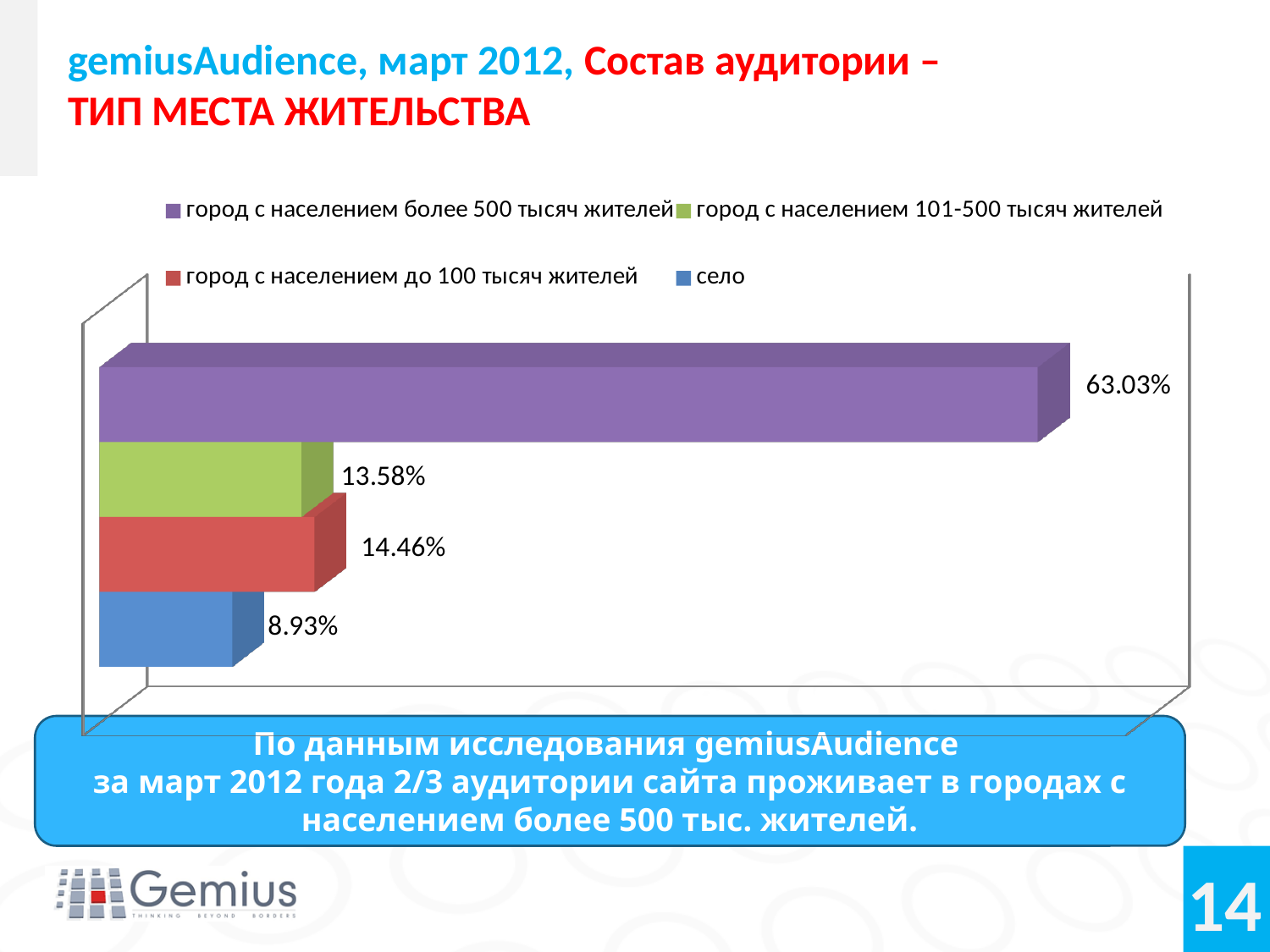
Which category has the highest value? город с населением более 500 тысяч жителей How many series does the legend list? 4 Which is larger: the value for город с населением до 100 тысяч жителей or for город с населением 101-500 тысяч жителей? город с населением до 100 тысяч жителей What is the value for город с населением 101-500 тысяч жителей? 13.58% What kind of chart is shown on the slide? bar chart What is the value for село? 8.93% What colour is the bar for село? blue What is the difference between the values for город с населением до 100 тысяч жителей and город с населением 101-500 тысяч жителей? 0.88% What is the value for город с населением до 100 тысяч жителей? 14.46% What is the difference between the values for город с населением более 500 тысяч жителей and село? 54.10% Which category has the lowest value? село What is the value for город с населением более 500 тысяч жителей? 63.03%